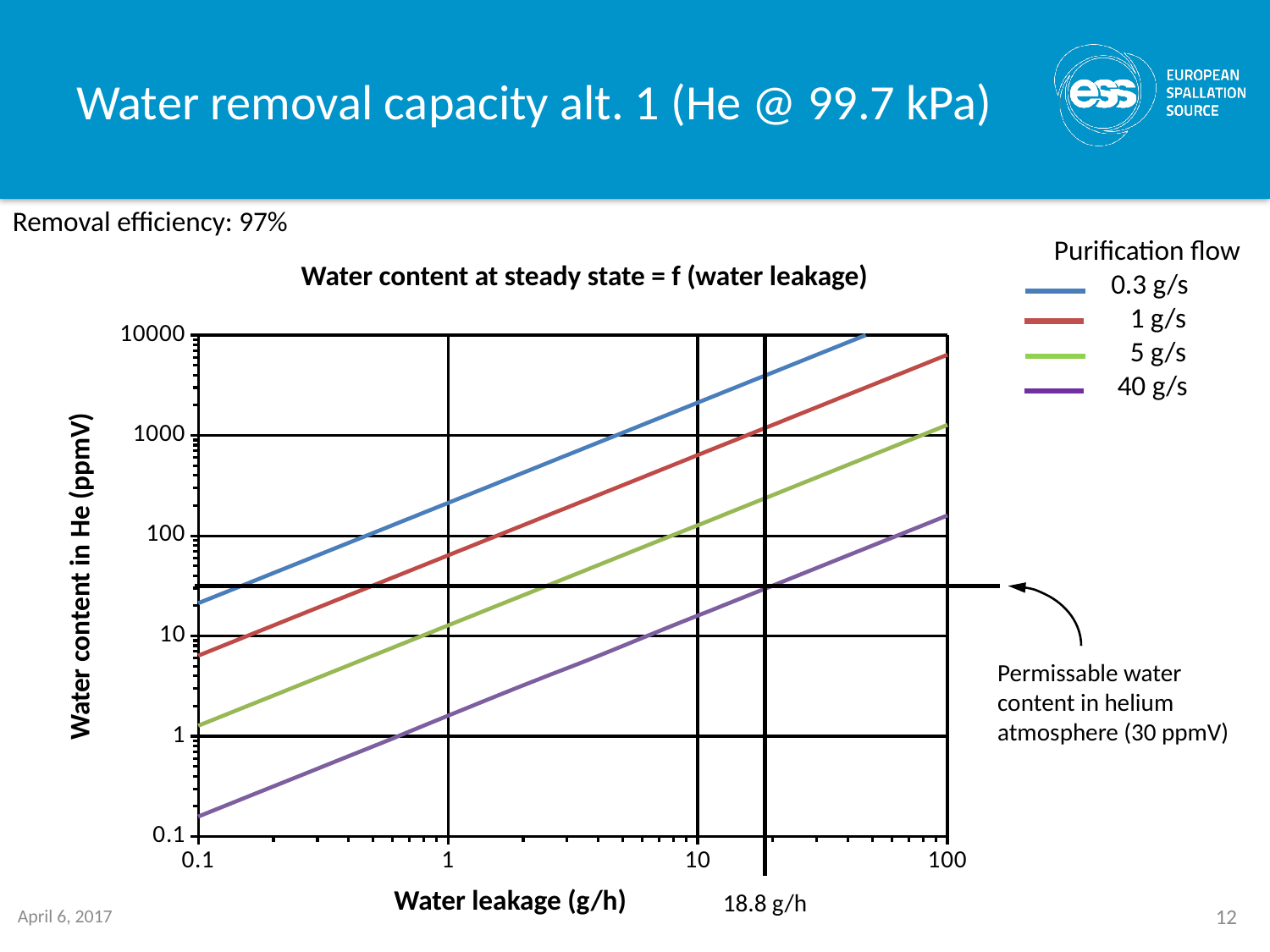
What is the title of the chart? Water content at steady state = f (water leakage) At a water leakage of 10 g/h, is the water content for the 1 g/s series greater or less than 1000 ppmV? less Which purification flow series has the lowest water content at a water leakage of 10 g/h? 40 g/s What is the label of the y axis? Water content in He (ppmV) What permissible water content in the helium atmosphere is marked by the horizontal line on the chart? 30 ppmV How many series does the legend list? 4 Which purification flow series has the highest water content at a water leakage of 10 g/h? 0.3 g/s At a water leakage of 10 g/h, which is larger: the water content for the 1 g/s series or for the 5 g/s series? 1 g/s At a water leakage of 1 g/h, is the water content for the 0.3 g/s series greater or less than 100 ppmV? greater At a water leakage of 1 g/h, is the water content for the 40 g/s series greater or less than 10 ppmV? less What kind of chart is shown on the slide? Line chart Do the plotted lines rise or fall as water leakage increases along the x axis? Rise